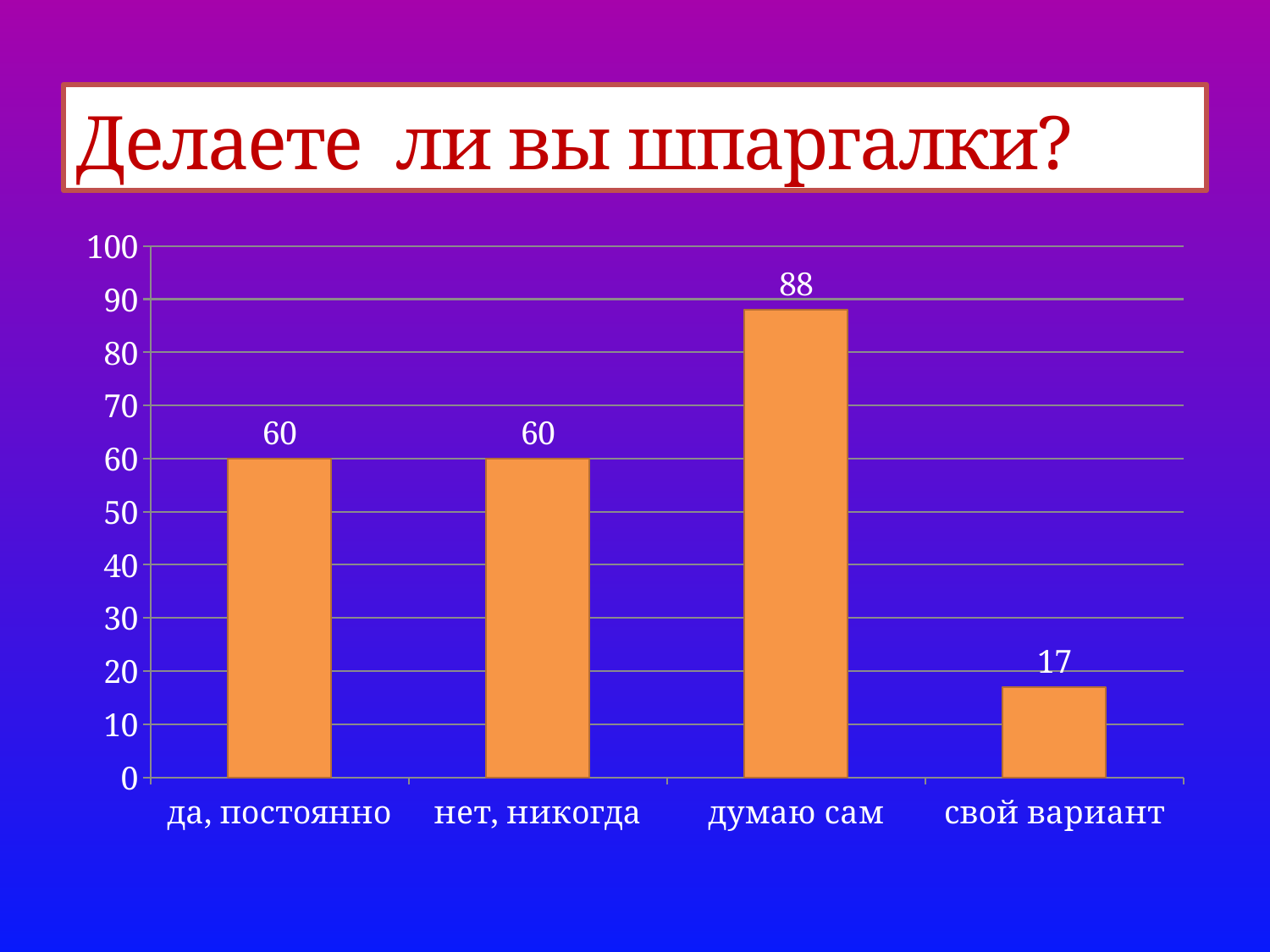
What kind of chart is shown on the slide? bar chart Which category has the lowest value? свой вариант Is the value for "свой вариант" greater or less than 20? less Which is larger, the value for "думаю сам" or the value for "да, постоянно"? думаю сам How many categories are shown on the chart? 4 What is the difference between the values for "думаю сам" and "нет, никогда"? 28 What is the title of the slide above the chart? Делаете ли вы шпаргалки? What is the value for "да, постоянно"? 60 Which category has the highest value? думаю сам What is the value for "думаю сам"? 88 What is the difference between the values for "думаю сам" and "свой вариант"? 71 What is the value for "свой вариант"? 17